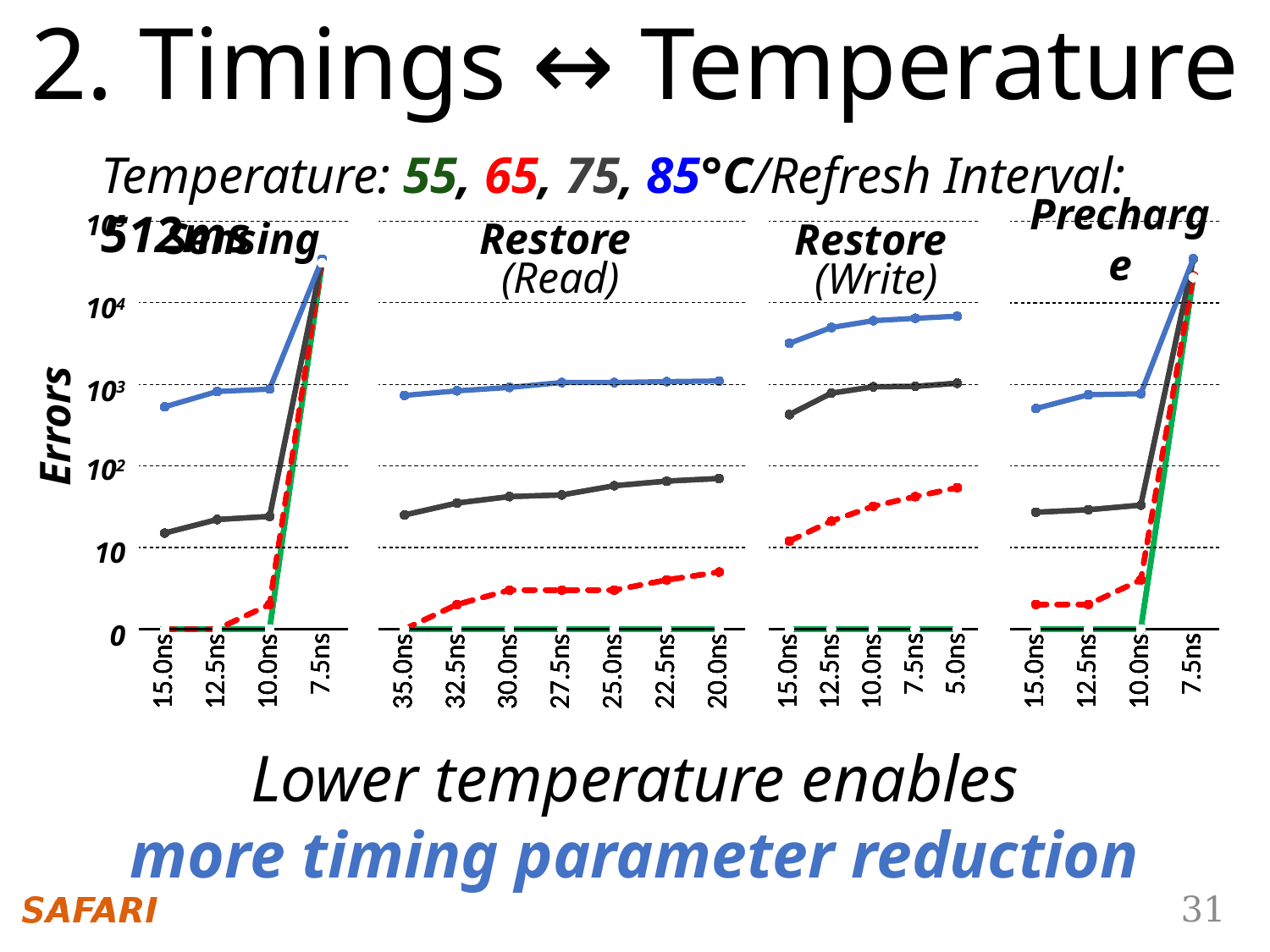
How many timing values are shown on the x axis of the Sensing chart? 4 In the Sensing chart, is the value for 85°C at 15.0ns greater or less than 10³? less In the Precharge chart, is the value for 75°C at 15.0ns greater or less than 10²? less How many temperature series are plotted in each chart? 4 In the Restore (Read) chart, which temperature line stays at 0 errors across all timings? 55°C What kind of chart is used for the Sensing panel? line chart In the Restore (Write) chart, is the value for 85°C at 5.0ns greater or less than 10³? greater In the Restore (Write) chart, which temperature has the highest number of errors? 85°C How many timing values are shown on the x axis of the Restore (Write) chart? 5 How many timing values are shown on the x axis of the Restore (Read) chart? 7 What is the label of the y axis shared by the four charts? Errors In the Restore (Read) chart, at 20.0ns, which has more errors: 85°C or 75°C? 85°C